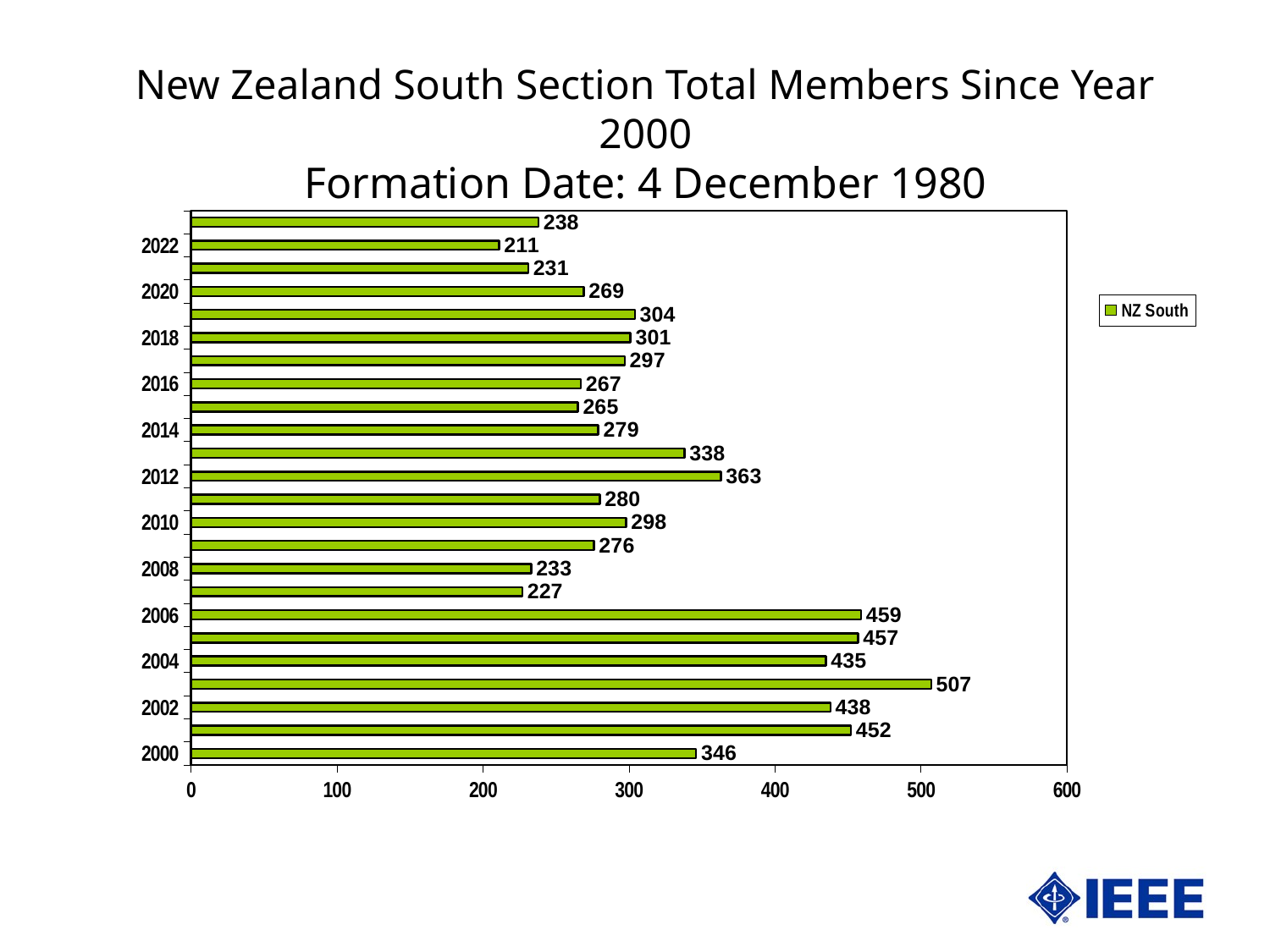
What is the value for 2022? 211 What is the highest value shown on the chart? 507 What is the value for 2012? 363 How many series does the legend list? 1 What is the value for 2000? 346 What kind of chart is shown? bar chart What is the difference between the values for 2006 and 2008? 226 Which is larger, the value for 2010 or the value for 2020? 2010 Is the value for 2004 greater or less than 400? greater How many bars are plotted on the chart? 24 Which year has the lowest value? 2022 What is the value for 2006? 459